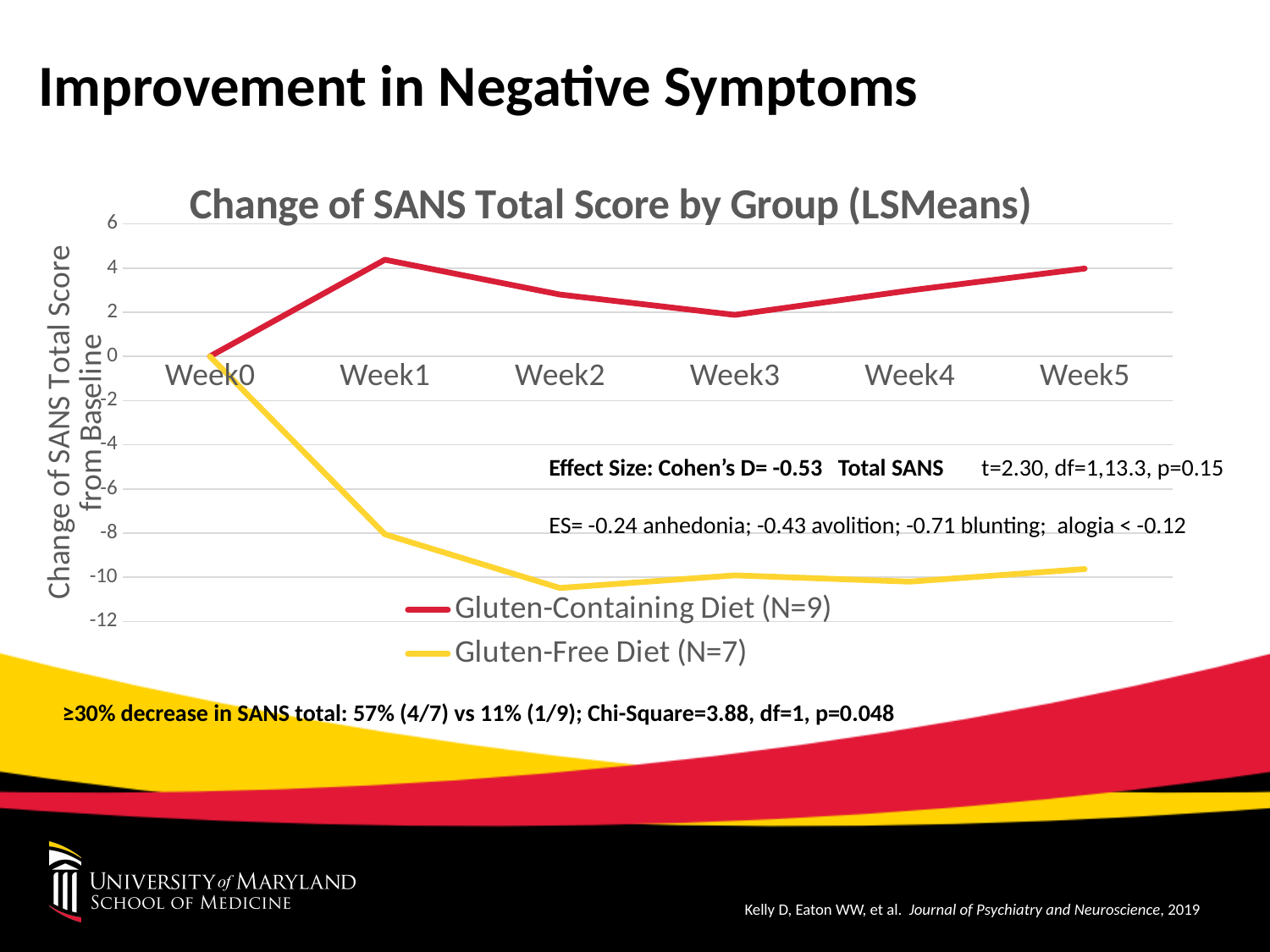
How many series does the chart legend list? 2 Which series has the higher value at Week4, Gluten-Containing Diet (N=9) or Gluten-Free Diet (N=7)? Gluten-Containing Diet (N=9) Is the value for the Gluten-Containing Diet (N=9) at Week1 greater or less than 4? greater How many weeks are shown on the x axis of the chart? 6 What type of chart is shown on the slide? line chart Which series is drawn in yellow? Gluten-Free Diet (N=7) Is the value for the Gluten-Containing Diet (N=9) at Week3 greater or less than 0? greater Does the Gluten-Free Diet (N=7) series rise or fall from Week0 to Week1? fall Is the value for the Gluten-Free Diet (N=7) at Week2 greater or less than -10? less What is the title of the chart? Change of SANS Total Score by Group (LSMeans) At which week does the Gluten-Containing Diet (N=9) series reach its highest value? Week1